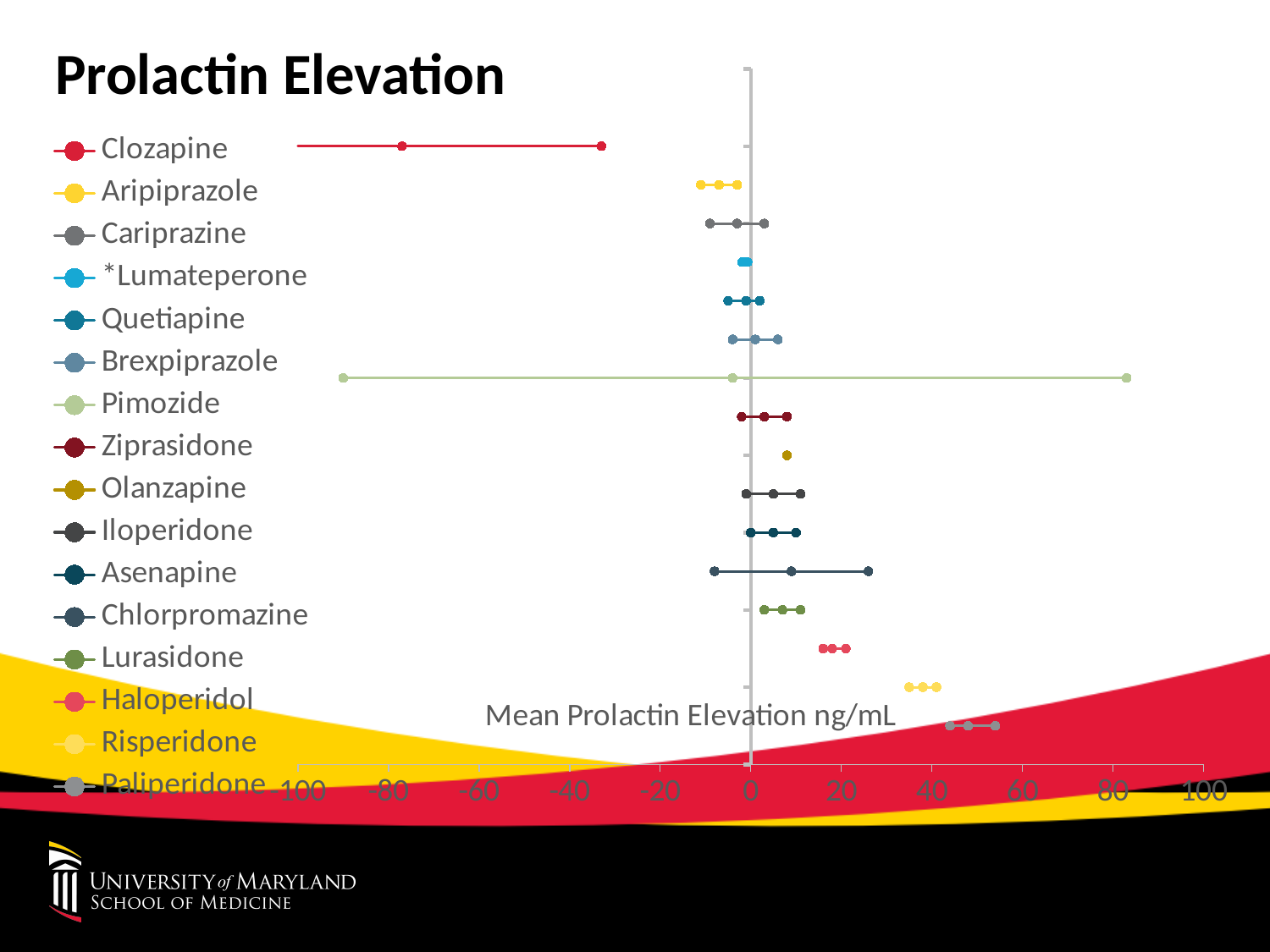
How many drugs (series) does the legend list? 16 Is the mean prolactin elevation for Risperidone greater or less than 20? greater Which has a higher mean prolactin elevation, Paliperidone or Risperidone? Paliperidone Which has a lower mean prolactin elevation, Clozapine or Aripiprazole? Clozapine Is the mean prolactin elevation for Aripiprazole greater or less than 0? less What is the title of the chart? Prolactin Elevation Is the mean prolactin elevation for Paliperidone greater or less than 40? greater Which drug has the lowest mean prolactin elevation on the chart? Clozapine What is the label on the horizontal axis of the chart? Mean Prolactin Elevation ng/mL Which drug has the highest mean prolactin elevation on the chart? Paliperidone